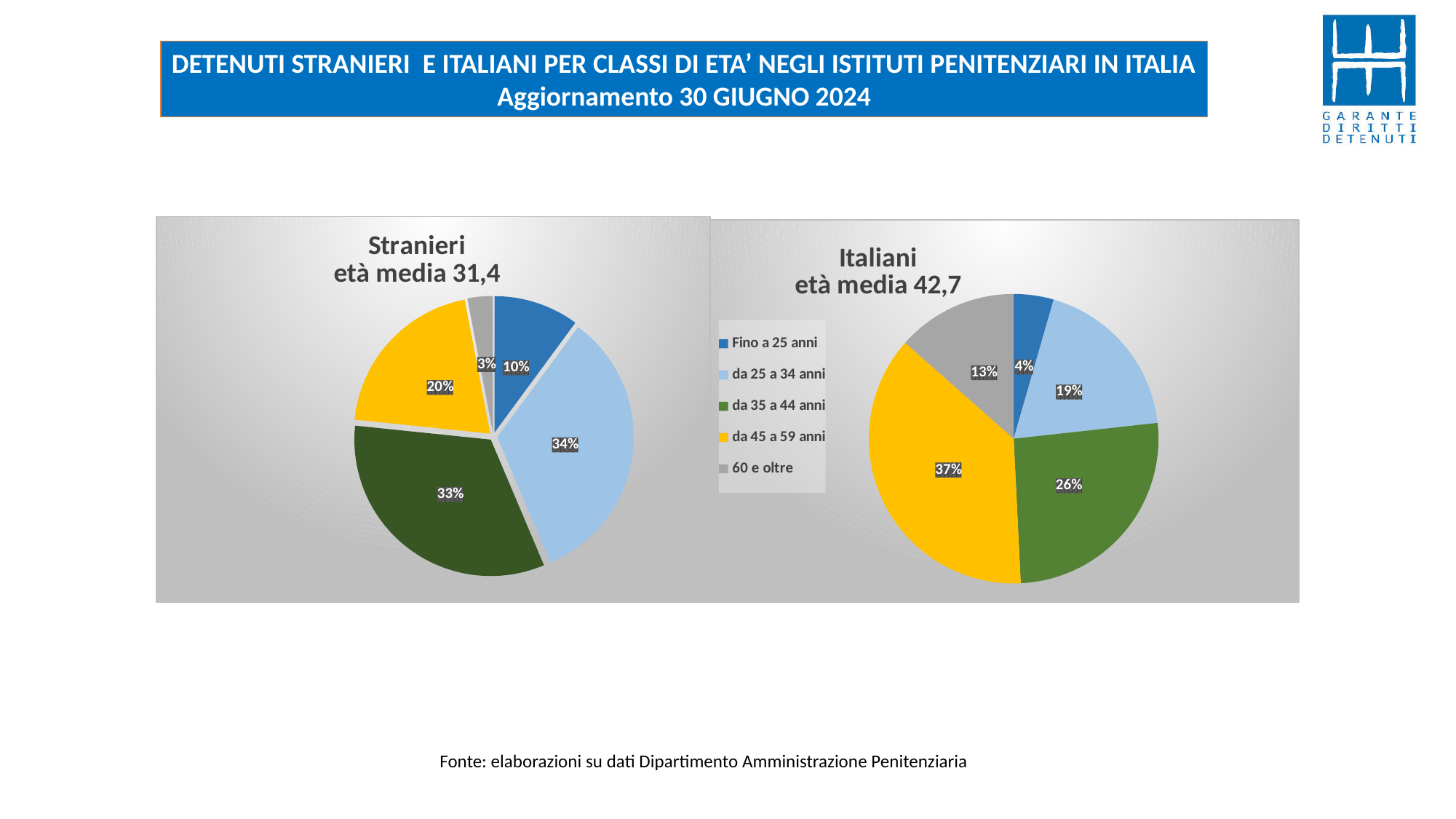
In the 'Stranieri' pie chart, what share is shown for 'da 25 a 34 anni'? 34% What is the average age ('età media') shown in the title of the 'Italiani' chart? 42,7 Which colour represents 'da 45 a 59 anni' in the legend? Yellow How many age classes does each pie chart show? 5 What type of chart is used on this slide? Pie chart What is the difference between the 'da 45 a 59 anni' share in the 'Italiani' chart and in the 'Stranieri' chart? 17 percentage points In the 'Italiani' pie chart, what share is shown for 'Fino a 25 anni'? 4% In the 'Stranieri' pie chart, which age class has the smallest share? 60 e oltre In the 'Stranieri' pie chart, what share is shown for '60 e oltre'? 3% In the 'Italiani' pie chart, what share is shown for 'da 45 a 59 anni'? 37% In the 'Italiani' pie chart, which age class has the largest share? da 45 a 59 anni Which chart shows a larger share for 'da 35 a 44 anni', 'Stranieri' or 'Italiani'? Stranieri